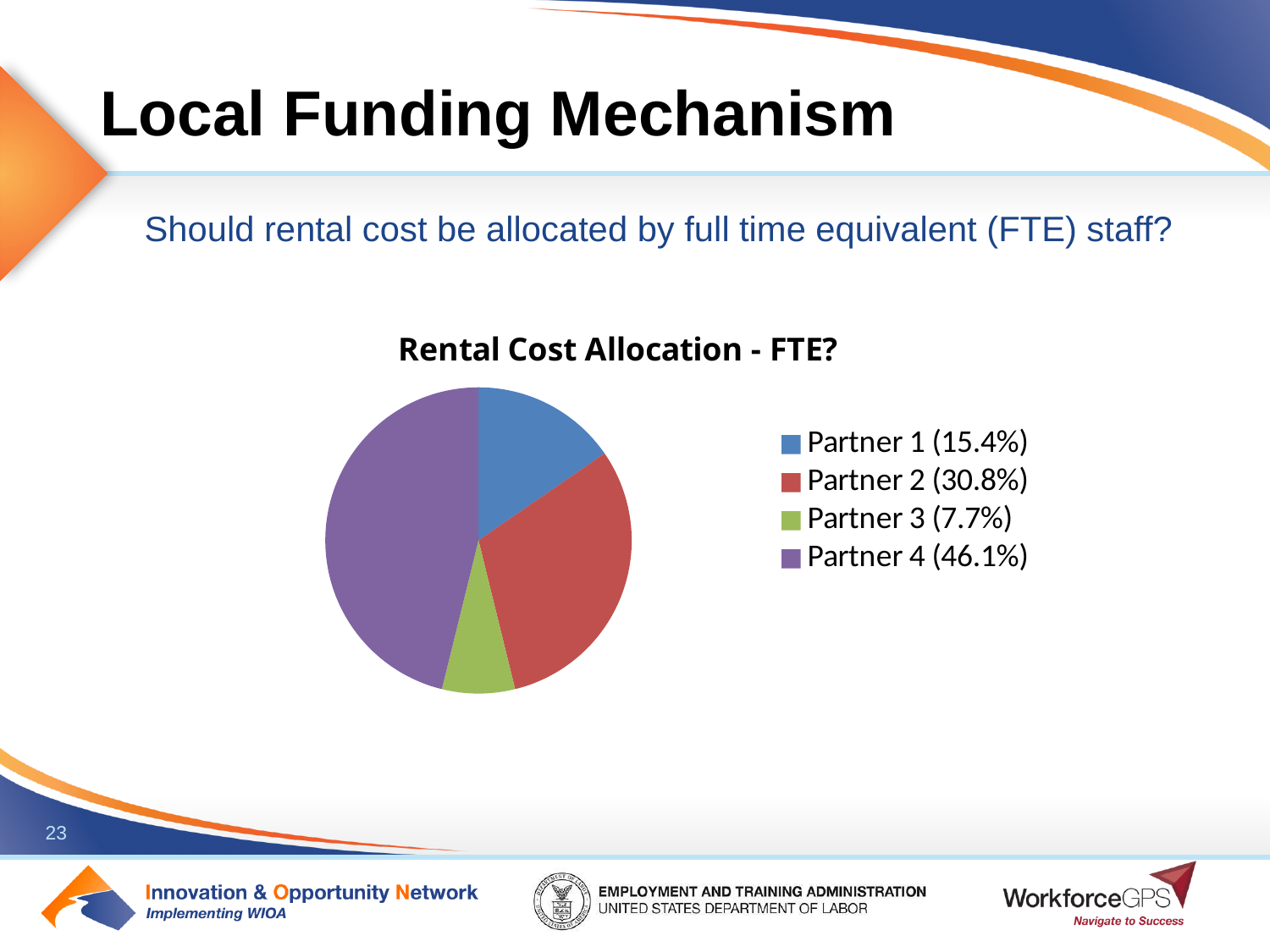
How many slices does the pie chart have? 4 What is the title of the chart? Rental Cost Allocation - FTE? What colour is the slice for Partner 3? green What share of the pie does Partner 4 have? 46.1% What share of the pie does Partner 2 have? 30.8% What is the difference between the shares of Partner 4 and Partner 2? 15.3% What type of chart is shown on the slide? pie chart What share of the pie does Partner 3 have? 7.7% Which partner has the smallest share of the pie? Partner 3 Which partner has the largest share of the pie? Partner 4 Which is larger, the share for Partner 2 or the share for Partner 1? Partner 2